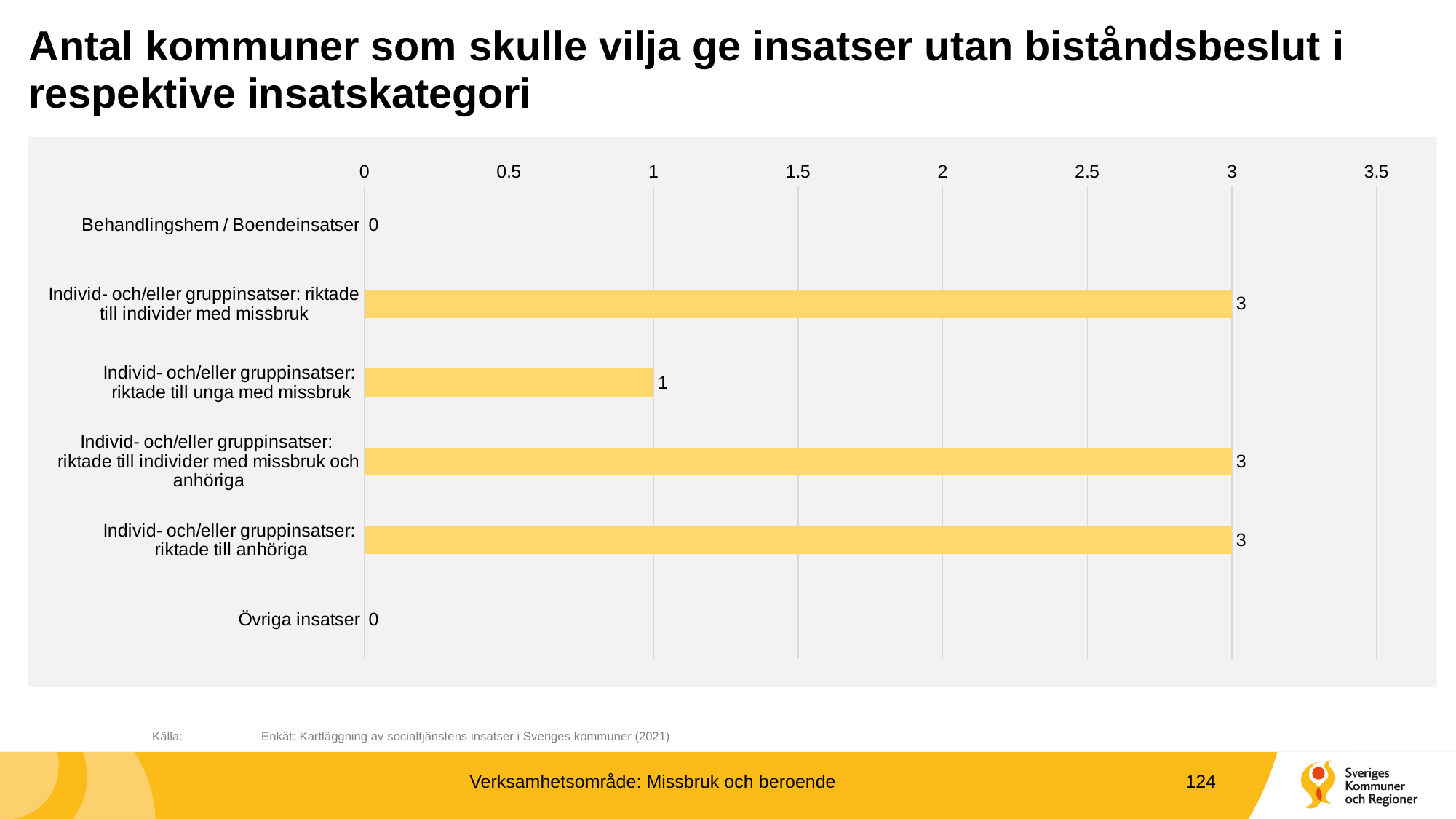
What is the difference between the value for Individ- och/eller gruppinsatser: riktade till individer med missbruk and the value for Individ- och/eller gruppinsatser: riktade till unga med missbruk? 2 What is the value for Individ- och/eller gruppinsatser: riktade till unga med missbruk? 1 How many categories are shown on the chart? 6 What kind of chart is shown on the slide? Bar chart What is the value for Individ- och/eller gruppinsatser: riktade till anhöriga? 3 What is the highest value shown on the x axis? 3.5 Which category has the lowest value among those with a non-zero bar? Individ- och/eller gruppinsatser: riktade till unga med missbruk Which is larger: the value for Individ- och/eller gruppinsatser: riktade till anhöriga or the value for Individ- och/eller gruppinsatser: riktade till unga med missbruk? Individ- och/eller gruppinsatser: riktade till anhöriga What is the value for Behandlingshem / Boendeinsatser? 0 How many categories have a value of 3? 3 What is the value for Individ- och/eller gruppinsatser: riktade till individer med missbruk? 3 What is the value for Övriga insatser? 0